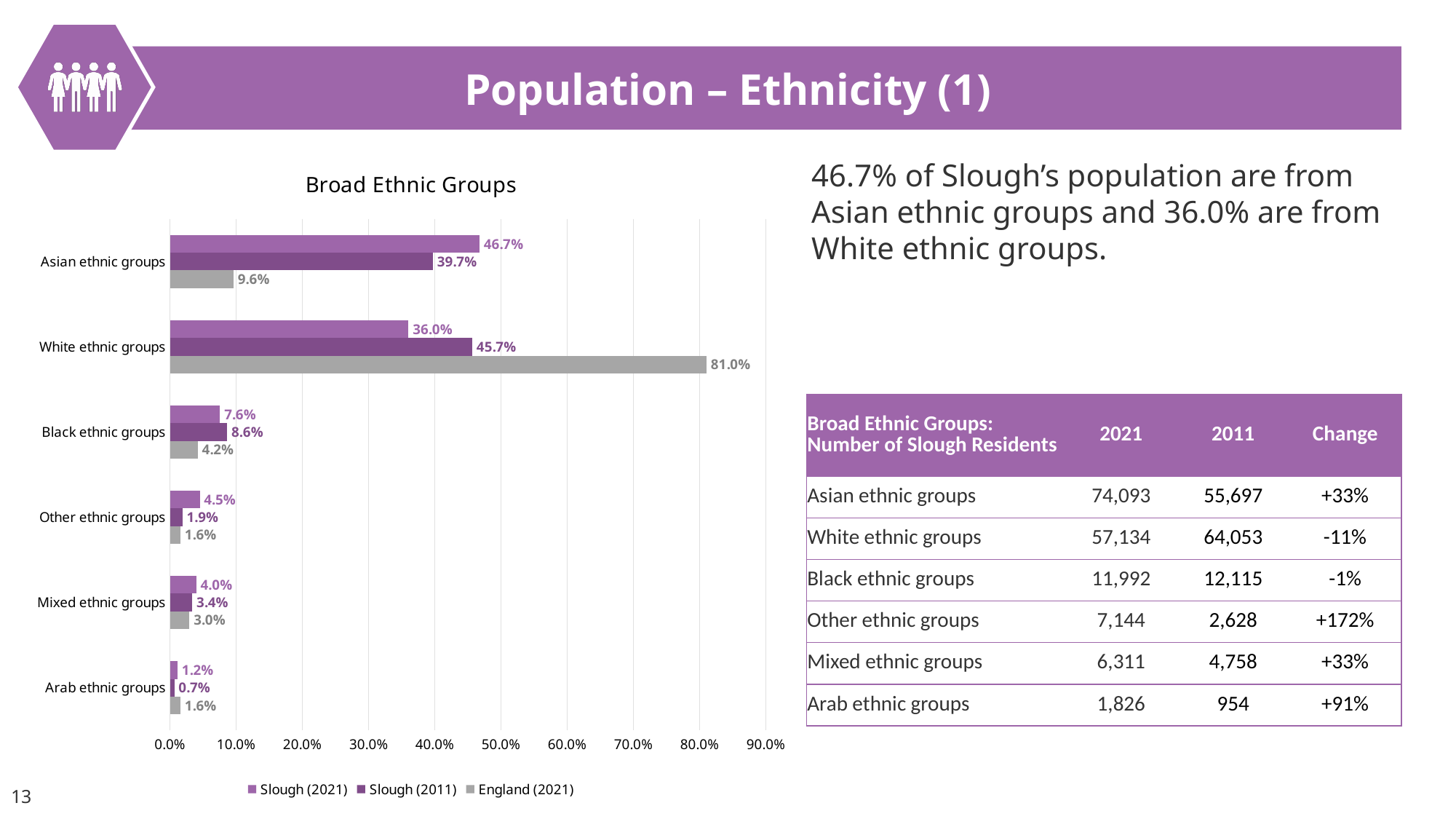
What is the Slough (2011) value for Black ethnic groups? 8.6% Which ethnic group has the highest Slough (2021) value? Asian ethnic groups How many ethnic group categories are shown on the chart? 6 What is the title of the chart? Broad Ethnic Groups Is the Slough (2011) value for Asian ethnic groups greater or less than 30.0%? greater What kind of chart is shown on the slide? Bar chart What is the England (2021) value for White ethnic groups? 81.0% How many series does the chart legend list? 3 Which is larger for Other ethnic groups: the Slough (2021) value or the England (2021) value? Slough (2021) What is the Slough (2021) value for Asian ethnic groups? 46.7% Which ethnic group has the lowest Slough (2011) value? Arab ethnic groups What is the difference between the Slough (2021) and Slough (2011) values for White ethnic groups? 9.7%